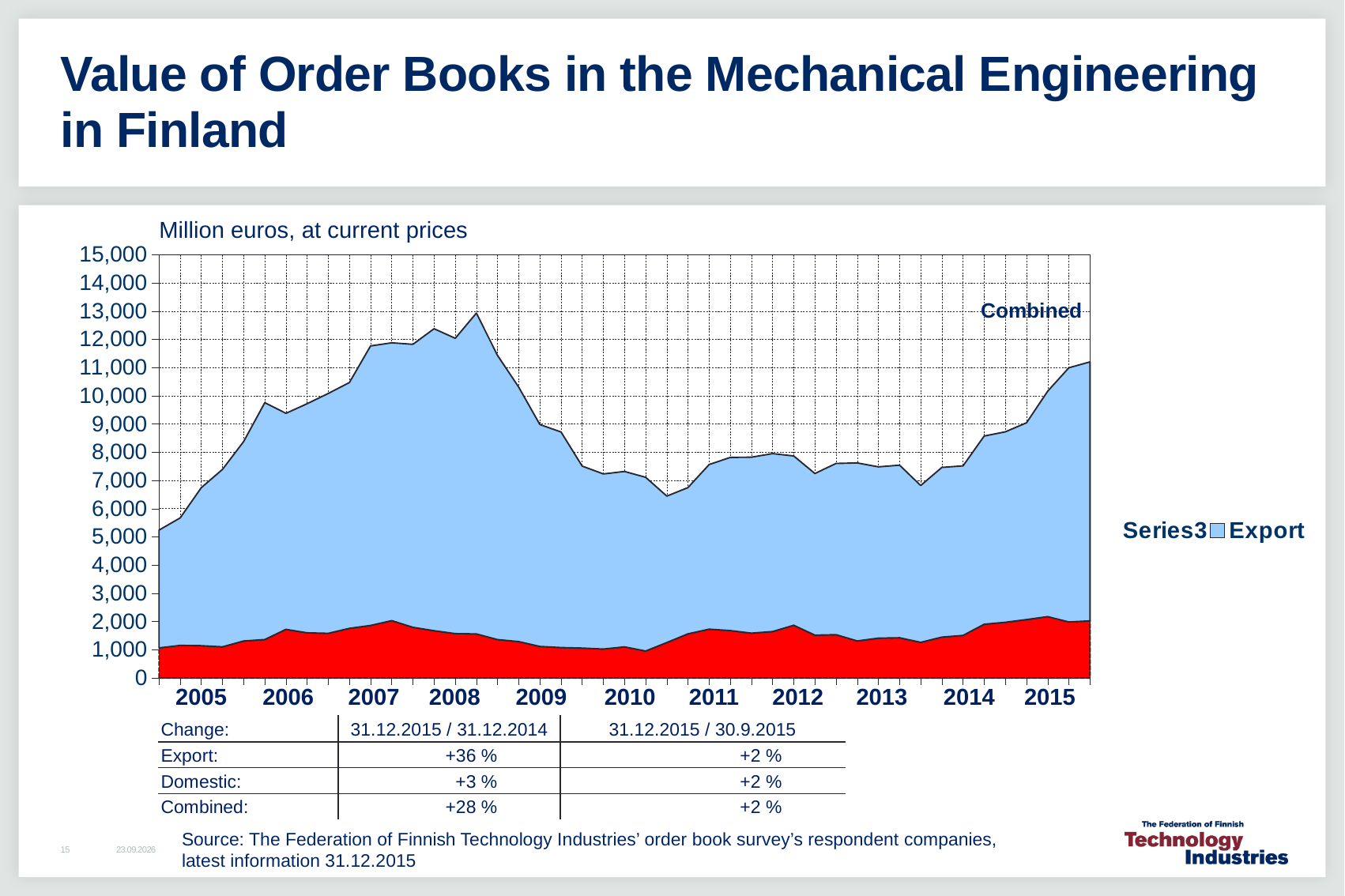
In which year does the Combined value reach its highest point? 2008 Is the peak Combined value in 2008 greater or less than 12,000? greater What kind of chart is shown on the slide? area chart What unit is stated above the chart? Million euros, at current prices Does the Combined value rise or fall between 2008 and 2010? fall Is the Combined value at the start of 2005 greater or less than 6,000? less How many entries does the chart legend list? 2 Does the Combined value rise or fall between 2013 and 2015? rise In which year is the Combined value at its lowest? 2005 How many years are labelled on the x axis? 11 Is the Combined value at the end of 2015 greater or less than 10,000? greater Which legend entry is shown with the light blue colour? Export